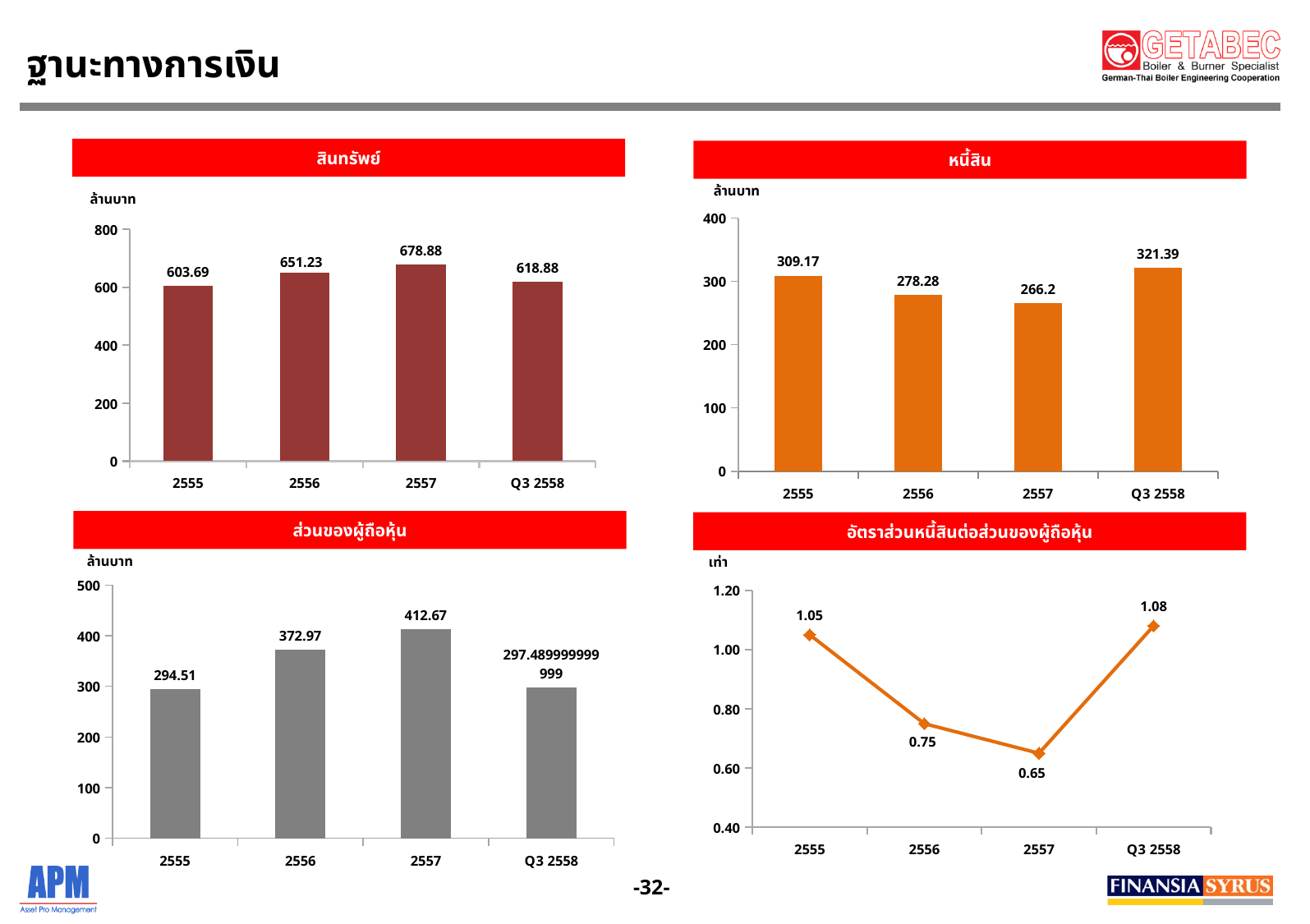
What kind of chart is the อัตราส่วนหนี้สินต่อส่วนของผู้ถือหุ้น chart (bottom right)? line chart In the สินทรัพย์ chart (top left), what is the difference between the values for 2557 and 2555? 75.19 In the หนี้สิน chart (top right), what is the value for Q3 2558? 321.39 In the ส่วนของผู้ถือหุ้น chart (bottom left), what is the value for 2556? 372.97 In the สินทรัพย์ chart (top left), what is the value for 2557? 678.88 In the สินทรัพย์ chart (top left), which year has the lowest value? 2555 In the หนี้สิน chart (top right), which year has the lowest value? 2557 In the หนี้สิน chart (top right), is the value for 2556 larger or smaller than the value for 2555? smaller In the ส่วนของผู้ถือหุ้น chart (bottom left), how many bars are plotted? 4 In the อัตราส่วนหนี้สินต่อส่วนของผู้ถือหุ้น chart (bottom right), what is the value for 2557? 0.65 In the ส่วนของผู้ถือหุ้น chart (bottom left), which year has the highest value? 2557 In the อัตราส่วนหนี้สินต่อส่วนของผู้ถือหุ้น chart (bottom right), does the value rise or fall from 2555 to 2557? fall